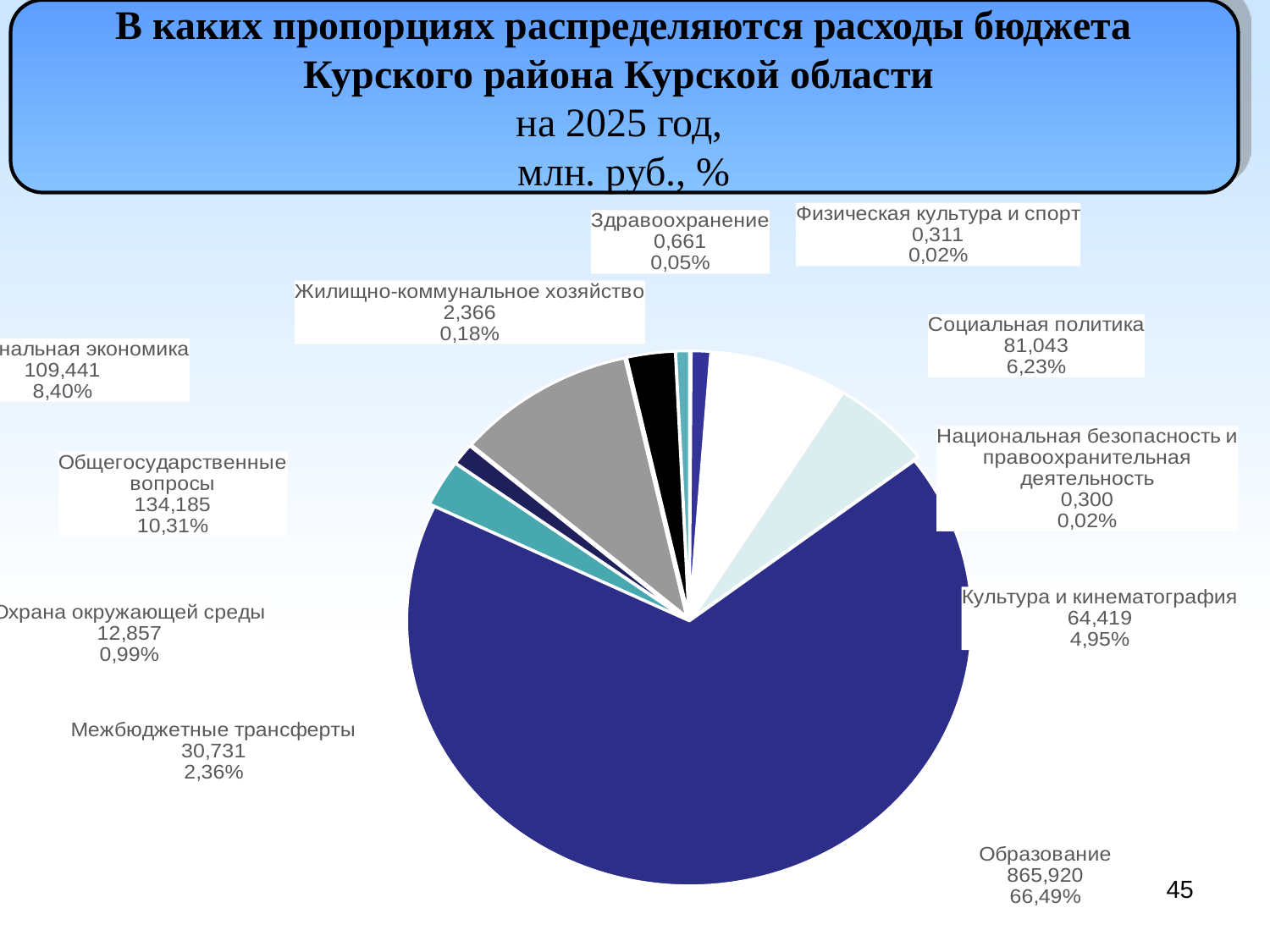
What percentage is shown for Социальная политика? 6,23% What is the value for Культура и кинематография? 64,419 What kind of chart is shown on the slide? pie chart How many categories are shown in the pie chart? 11 What share of the pie does Образование represent? 66,49% What percentage is shown for Жилищно-коммунальное хозяйство? 0,18% Which is larger, Межбюджетные трансферты or Охрана окружающей среды? Межбюджетные трансферты Which category has the smallest value in million rubles? Национальная безопасность и правоохранительная деятельность What is the difference in million rubles between Общегосударственные вопросы and Социальная политика? 53,142 Which category has the largest share of the budget expenditures? Образование What is the value for Общегосударственные вопросы? 134,185 What is the value in million rubles for Образование? 865,920